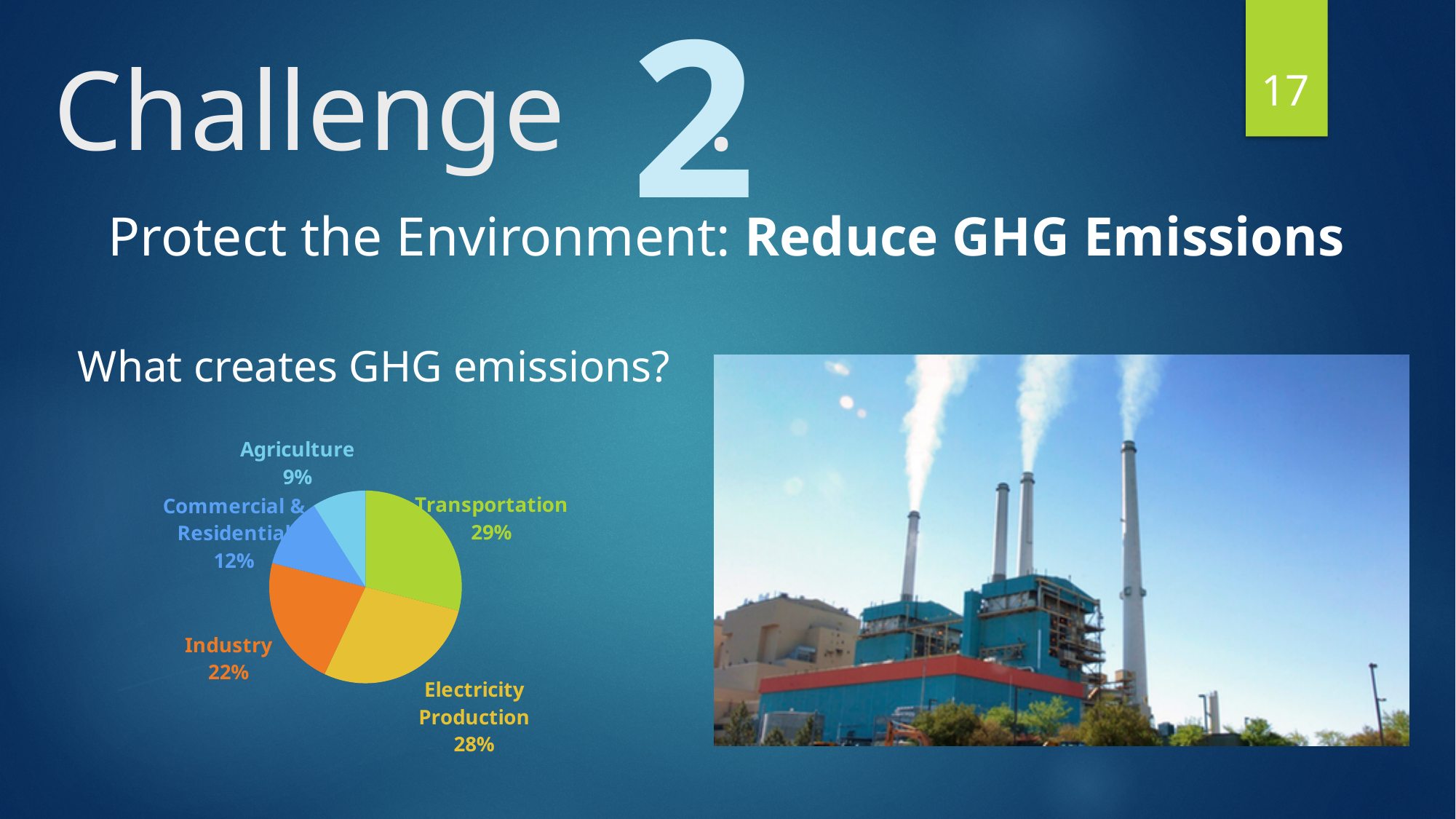
What percentage is shown for Commercial & Residential? 12% Which is larger, the share for Industry or the share for Commercial & Residential? Industry What percentage of GHG emissions comes from Electricity Production? 28% What share of GHG emissions is attributed to Agriculture? 9% What type of chart is used to show what creates GHG emissions? Pie chart What colour is the Industry slice in the pie chart? Orange Which category has the largest share of GHG emissions in the pie chart? Transportation What share of GHG emissions does Transportation account for in the pie chart? 29% What is the value shown for Industry in the pie chart? 22% What is the difference in percentage points between Transportation and Industry? 7 Which category has the smallest share of GHG emissions in the pie chart? Agriculture How many categories are shown in the pie chart? 5